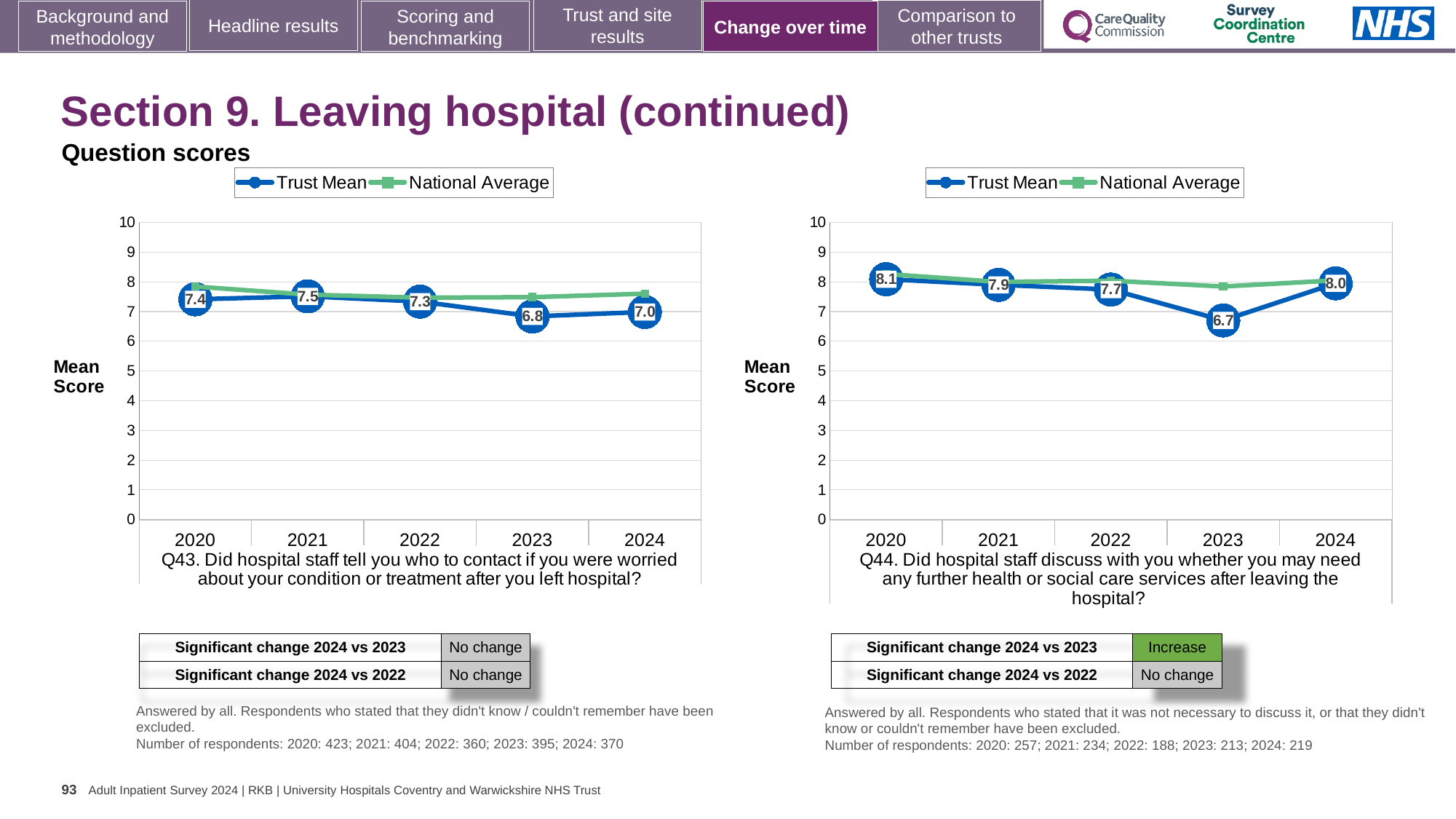
In the Q43 chart (left), what is the Trust Mean score for 2023? 6.8 In the Q43 chart (left), which year has the highest Trust Mean score? 2021 In the Q44 chart (right), is the National Average value for 2023 greater or less than 7? greater In the Q43 chart (left), what is the difference between the Trust Mean scores for 2021 and 2023? 0.7 In the Q44 chart (right), what is the Trust Mean score for 2020? 8.1 In the Q44 chart (right), which year has the lowest Trust Mean score? 2023 How many years are plotted on the x axis of the Q43 chart (left)? 5 In the Q44 chart (right), what is the difference between the Trust Mean scores for 2024 and 2023? 1.3 How many series does the legend of the Q44 chart (right) list? 2 In the Q43 chart (left), is the Trust Mean score for 2020 larger or smaller than the Trust Mean score for 2024? larger In the Q43 chart (left), what is the Trust Mean score for 2021? 7.5 In the Q44 chart (right), what is the Trust Mean score for 2024? 8.0